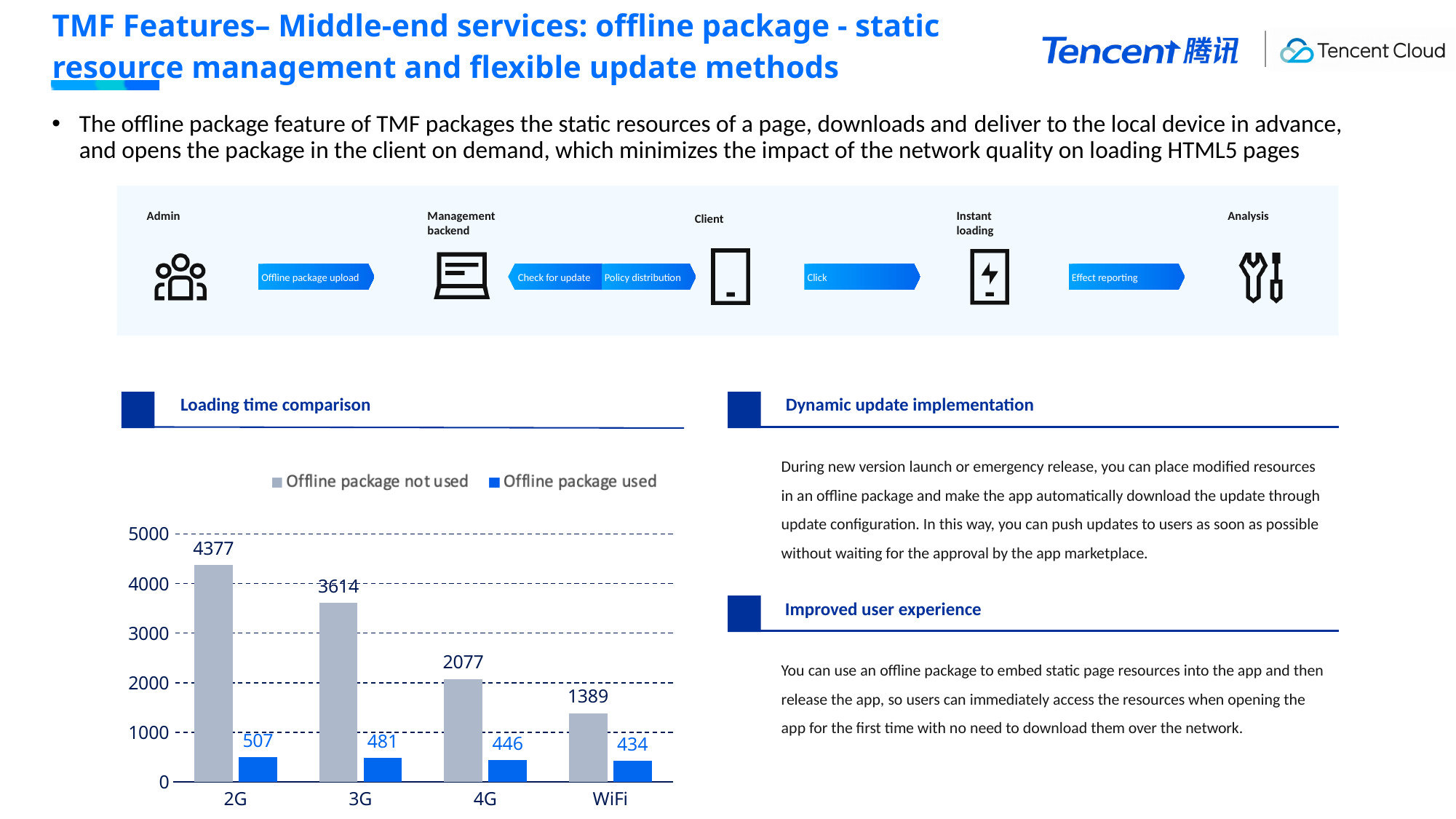
Which category has the lowest value in the 'Offline package used' series? WiFi How many categories are shown on the x axis of the chart? 4 What is the difference between the 'Offline package not used' and 'Offline package used' values for 3G? 3133 Is the 'Offline package not used' value for WiFi greater or less than 2000? less What is the value for 4G in the 'Offline package not used' series? 2077 Do the 'Offline package not used' values rise or fall from 2G to WiFi? Fall What kind of chart is shown under 'Loading time comparison'? Bar chart Which category has the highest value in the 'Offline package not used' series? 2G What is the value for WiFi in the 'Offline package used' series? 434 What is the value for 2G in the 'Offline package not used' series? 4377 Which is larger: the 'Offline package used' value for 2G or for 4G? 2G How many series does the chart legend list? 2